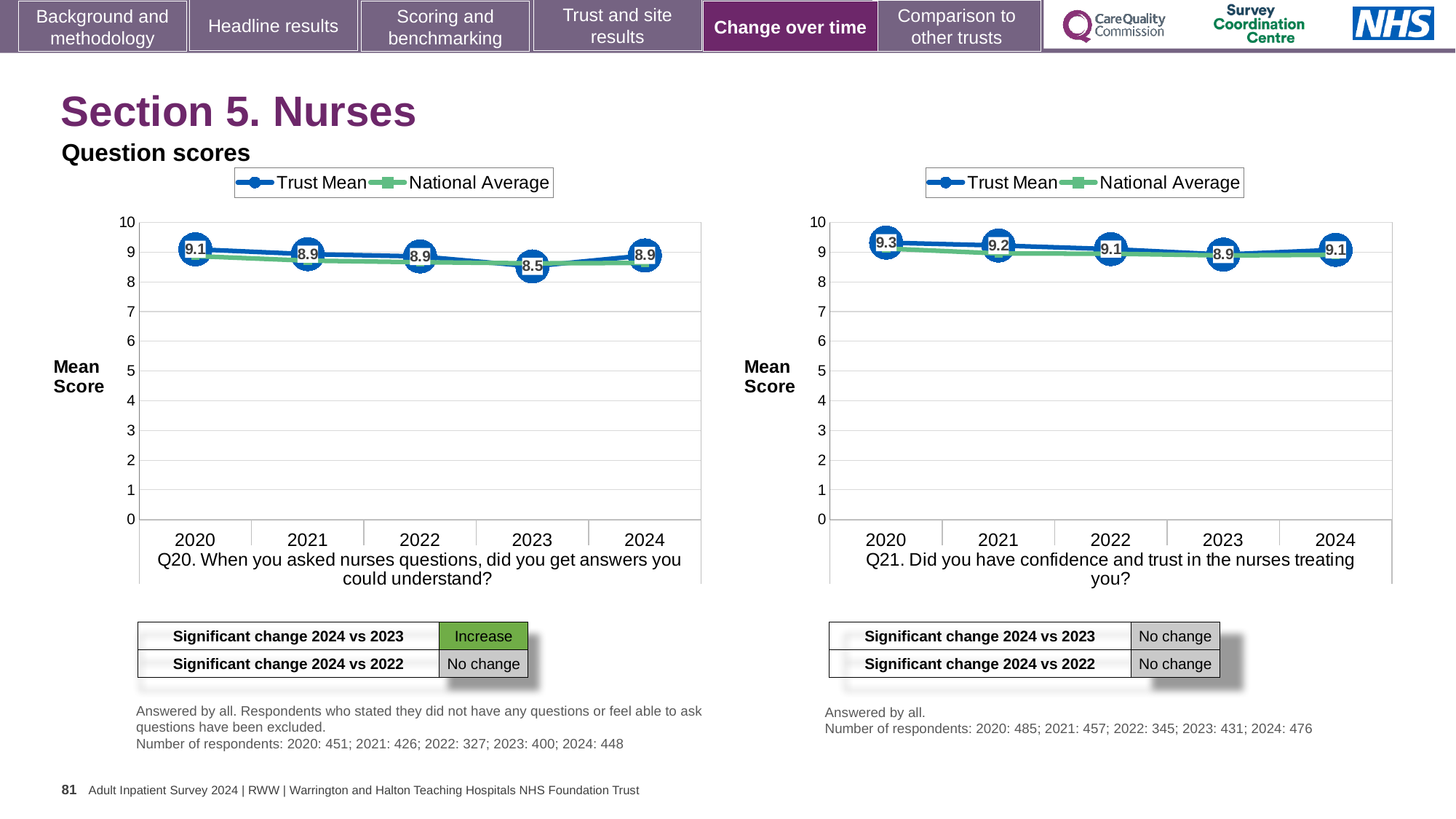
In the Q20 chart (left), what is the difference between the Trust Mean scores for 2024 and 2023? 0.4 In the Q21 chart (right), what is the difference between the Trust Mean scores for 2020 and 2023? 0.4 In the Q21 chart (right), is the Trust Mean score for 2021 larger or smaller than the score for 2023? larger In the Q20 chart (left), which year has the lowest Trust Mean score? 2023 What type of chart is used for Q20 (left)? Line chart In the Q21 chart (right), what is the Trust Mean score for 2024? 9.1 In the Q21 chart (right), which year has the highest Trust Mean score? 2020 In the Q20 chart (left), what is the Trust Mean score for 2020? 9.1 How many years are plotted on the x axis of the Q20 chart (left)? 5 How many series does the legend of the Q21 chart (right) list? 2 In the Q20 chart (left), what is the Trust Mean score for 2023? 8.5 In the Q21 chart (right), what is the Trust Mean score for 2020? 9.3